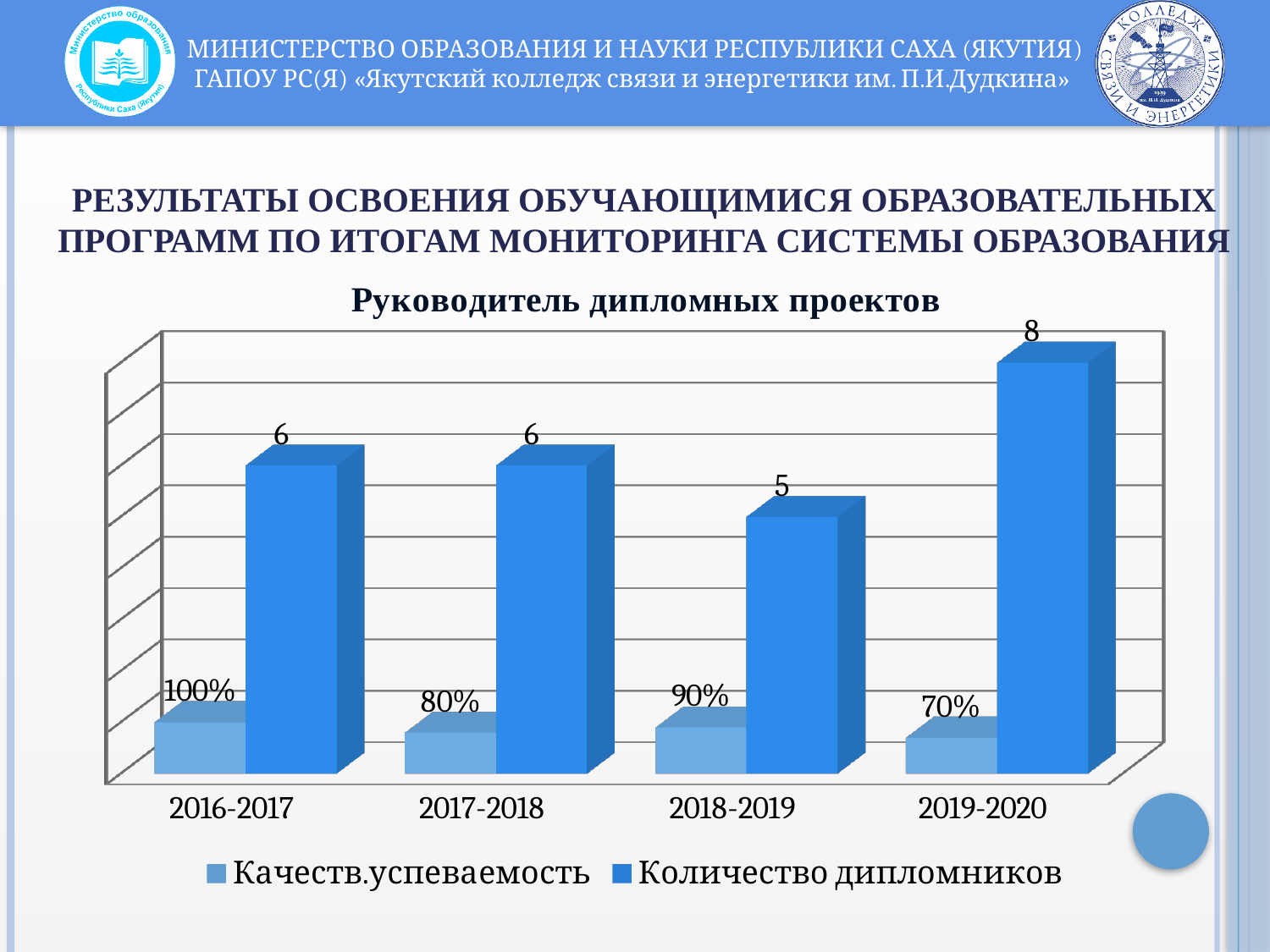
What is the value of Качеств.успеваемость for 2018-2019? 90% What is the title of the chart? Руководитель дипломных проектов What is the value of Количество дипломников for 2018-2019? 5 What is the value of Качеств.успеваемость for 2016-2017? 100% How many year categories are shown on the x axis? 4 Which year has the lowest Качеств.успеваемость? 2019-2020 How many series does the legend list? 2 What kind of chart is shown on the slide? Bar chart Which year has the highest Количество дипломников? 2019-2020 What is the difference in Количество дипломников between 2019-2020 and 2018-2019? 3 Which is larger: Качеств.успеваемость for 2017-2018 or for 2018-2019? 2018-2019 What is the value of Количество дипломников for 2019-2020? 8